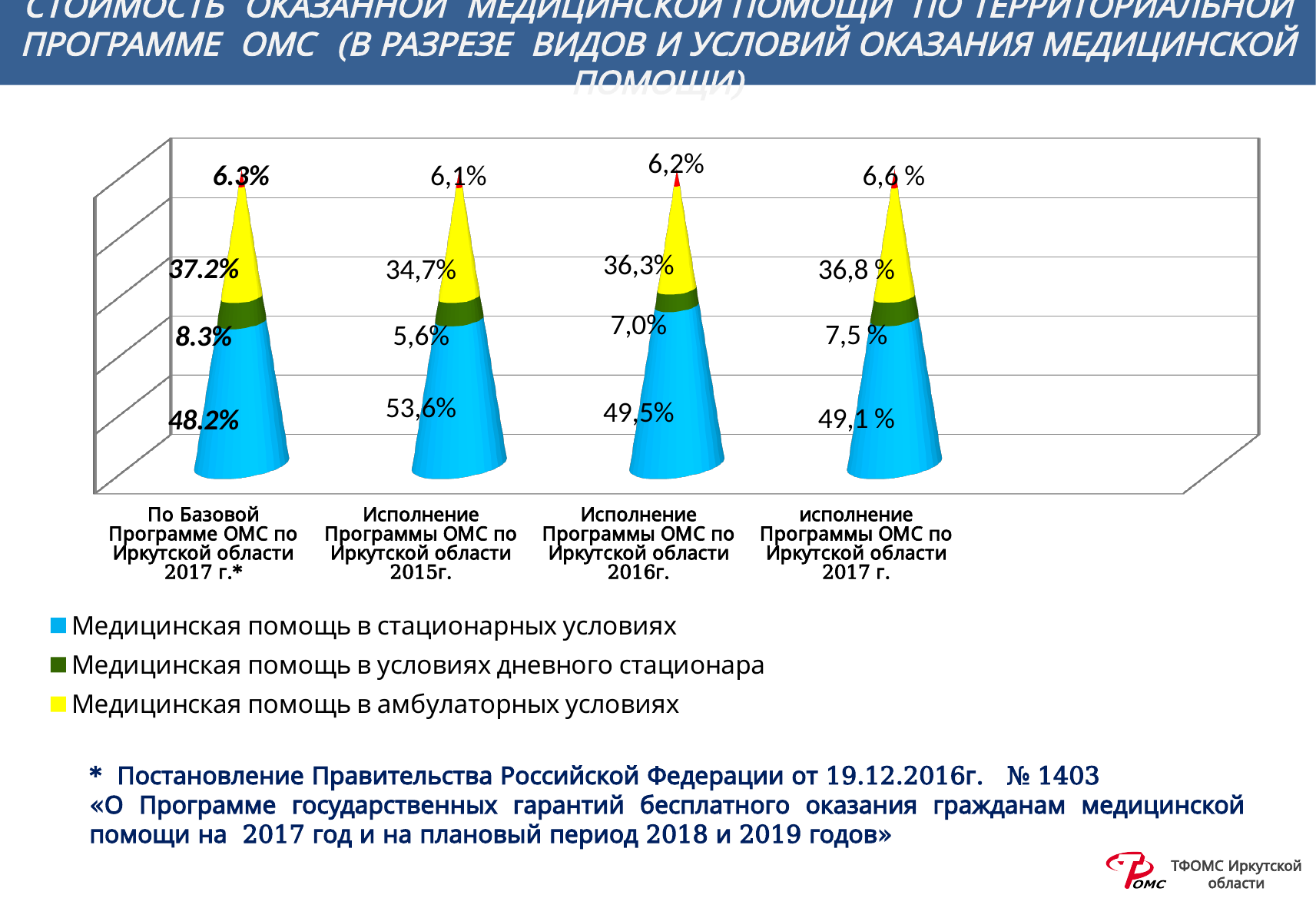
How many series does the legend list? 3 What is the value for ambulatory care (Медицинская помощь в амбулаторных условиях) for Исполнение Программы ОМС по Иркутской области 2016г.? 36,3% What is the value for day-hospital care (Медицинская помощь в условиях дневного стационара) for исполнение Программы ОМС по Иркутской области 2017 г.? 7,5 % Which category has the highest value for stationary medical care (Медицинская помощь в стационарных условиях)? Исполнение Программы ОМС по Иркутской области 2015г. Which category has the lowest value for day-hospital care (Медицинская помощь в условиях дневного стационара)? Исполнение Программы ОМС по Иркутской области 2015г. Which colour represents ambulatory care (Медицинская помощь в амбулаторных условиях) in the chart? Yellow How many categories are shown on the x axis of the chart? 4 What is the difference between the stationary care values for Исполнение Программы ОМС 2015г. and Исполнение Программы ОМС 2016г.? 4,1% What is the value for ambulatory care (Медицинская помощь в амбулаторных условиях) for По Базовой Программе ОМС по Иркутской области 2017 г.*? 37.2% Which is larger: the ambulatory care value for Исполнение Программы ОМС 2015г. or for исполнение Программы ОМС 2017 г.? исполнение Программы ОМС по Иркутской области 2017 г. Which category has the highest value for day-hospital care (Медицинская помощь в условиях дневного стационара)? По Базовой Программе ОМС по Иркутской области 2017 г.* What is the value for stationary medical care (Медицинская помощь в стационарных условиях) for Исполнение Программы ОМС по Иркутской области 2015г.? 53,6%